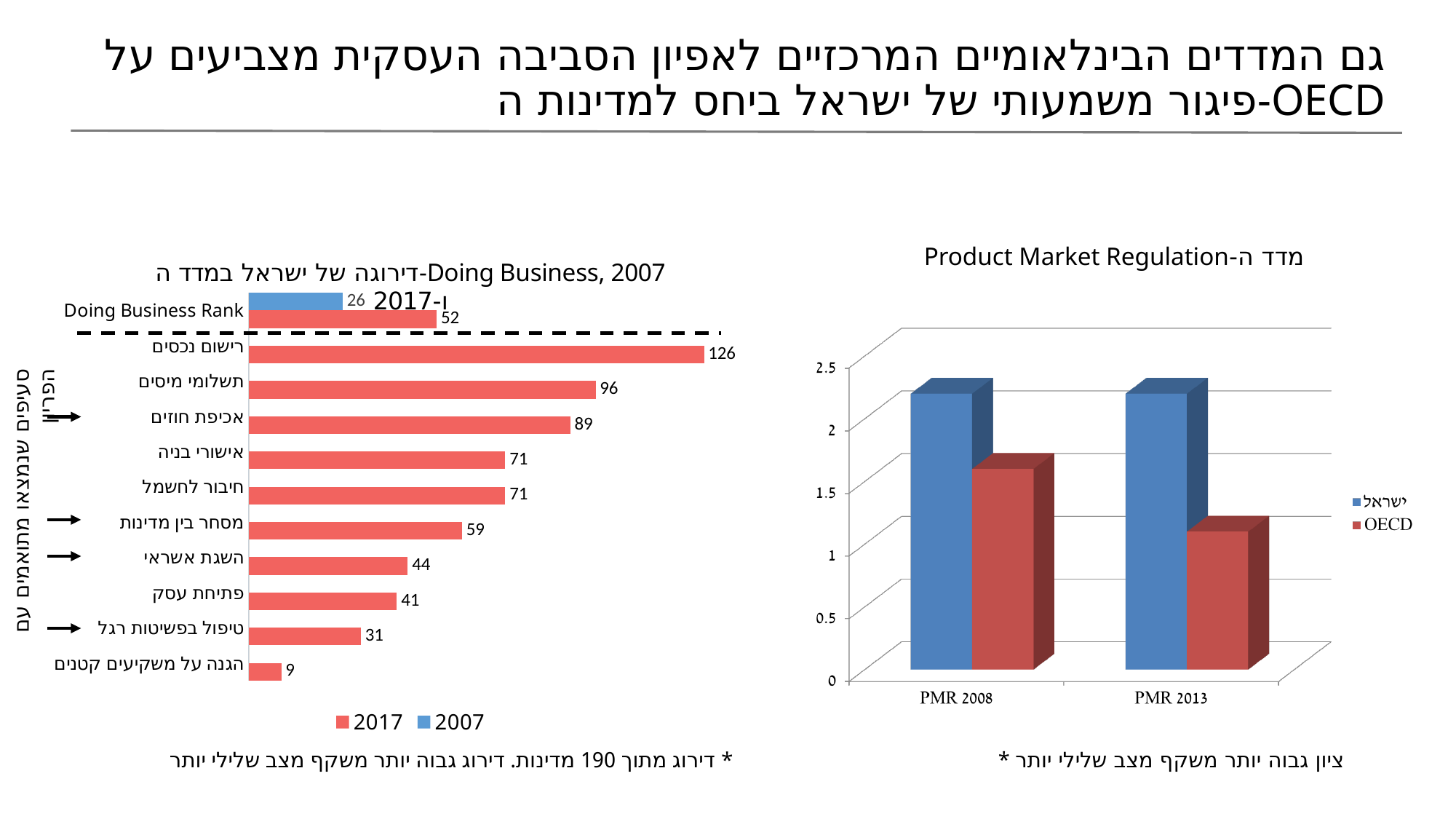
In the Doing Business chart on the left, what was Israel's Doing Business Rank in 2007? 26 In the Doing Business chart on the left, what is the value for השגת אשראי? 44 In the Product Market Regulation chart on the right, is the value for OECD in PMR 2013 greater or less than 1.5? less In the Product Market Regulation chart on the right, is the value for ישראל in PMR 2008 greater or less than 2? greater In the Doing Business chart on the left, which is larger: the value for תשלומי מיסים or the value for אכיפת חוזים? תשלומי מיסים In the Doing Business chart on the left, what is the value for רישום נכסים? 126 In the Doing Business chart on the left, which sub-category has the highest value? רישום נכסים What kind of chart is the Product Market Regulation chart on the right? Bar chart In the Doing Business chart on the left, what was Israel's Doing Business Rank in 2017? 52 In the Doing Business chart on the left, which sub-category has the lowest value? הגנה על משקיעים קטנים In the Doing Business chart on the left, what is the difference between the 2017 and 2007 Doing Business Rank values? 26 In the Doing Business chart on the left, how many series does the legend list? 2